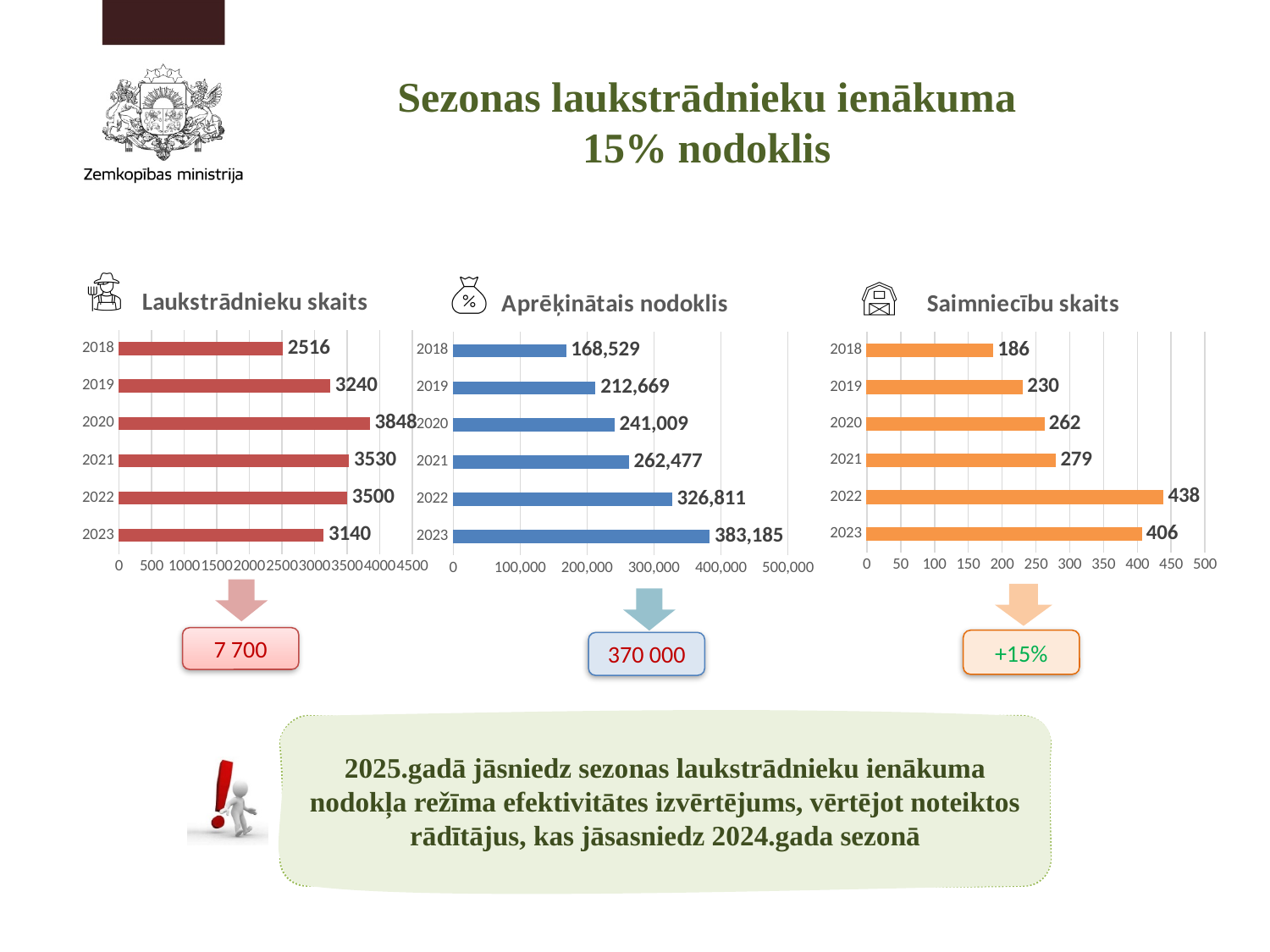
In the 'Saimniecību skaits' chart, what is the value for 2021? 279 In the 'Laukstrādnieku skaits' chart, what is the value for 2020? 3848 In the 'Saimniecību skaits' chart, which is larger, the value for 2022 or the value for 2023? 2022 In the 'Aprēķinātais nodoklis' chart, is the value for 2021 greater or less than 300,000? less In the 'Laukstrādnieku skaits' chart, what is the difference between the values for 2019 and 2018? 724 In the 'Aprēķinātais nodoklis' chart, which year has the highest value? 2023 In the 'Saimniecību skaits' chart, which year has the highest value? 2022 How many years are shown in the 'Saimniecību skaits' chart? 6 In the 'Laukstrādnieku skaits' chart, which year has the lowest value? 2018 What kind of chart is the 'Laukstrādnieku skaits' chart? bar chart In the 'Aprēķinātais nodoklis' chart, do the values rise or fall from 2018 to 2023? rise In the 'Aprēķinātais nodoklis' chart, what is the value for 2022? 326,811